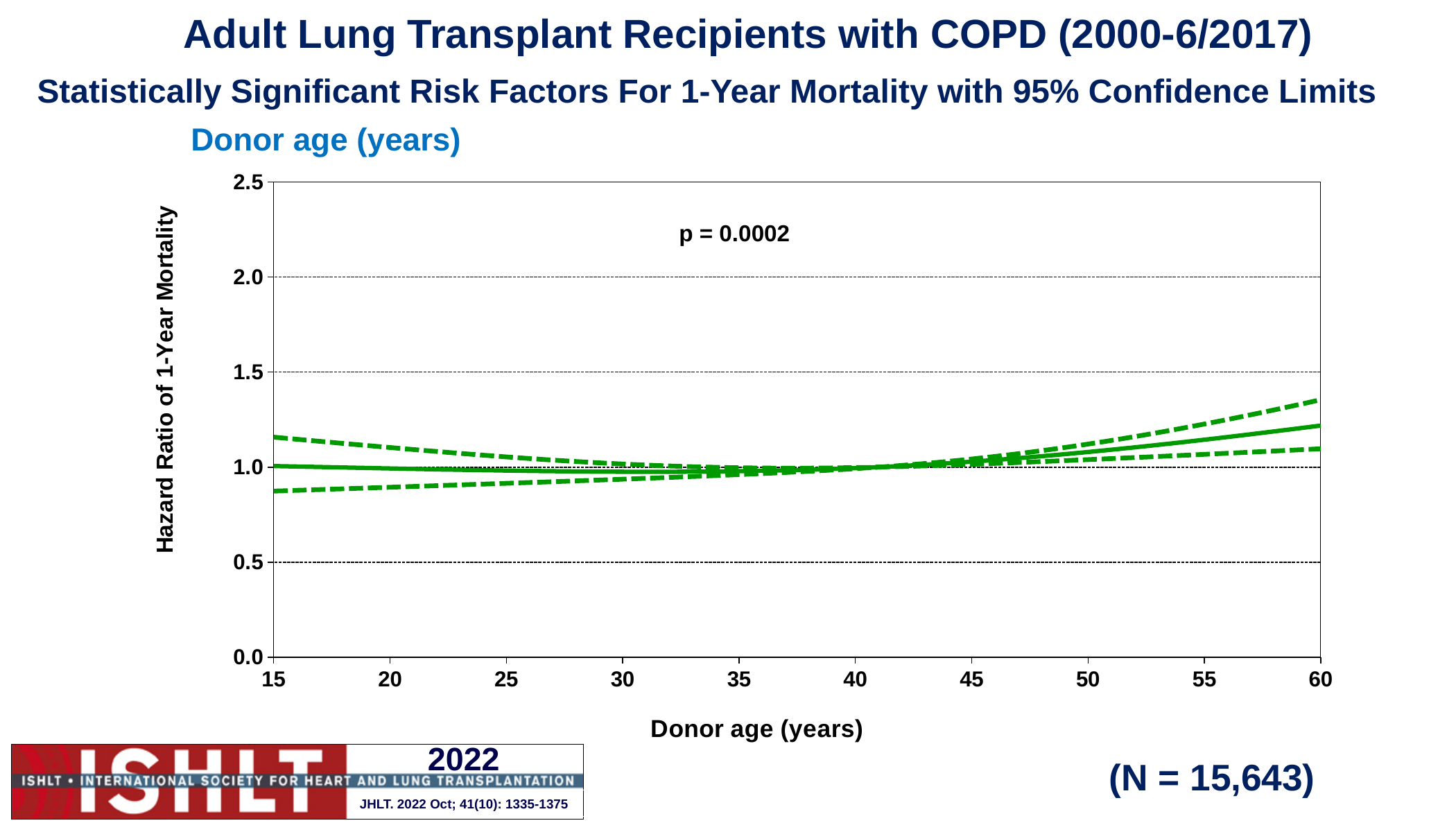
What is the p-value printed on the chart? p = 0.0002 Is the upper dashed confidence limit at donor age 15 greater or less than 1.0? greater Is the hazard ratio on the solid line at donor age 60 greater or less than 1.5? less Does the solid hazard ratio line rise or fall as donor age increases from 15 to 60 years? rise What sample size (N) is printed on the slide? N = 15,643 Is the hazard ratio on the solid line higher at donor age 60 or at donor age 15? 60 Is the hazard ratio on the solid line at donor age 60 greater or less than 1.0? greater What kind of chart is shown on the slide? line chart How many lines are plotted on the chart? 3